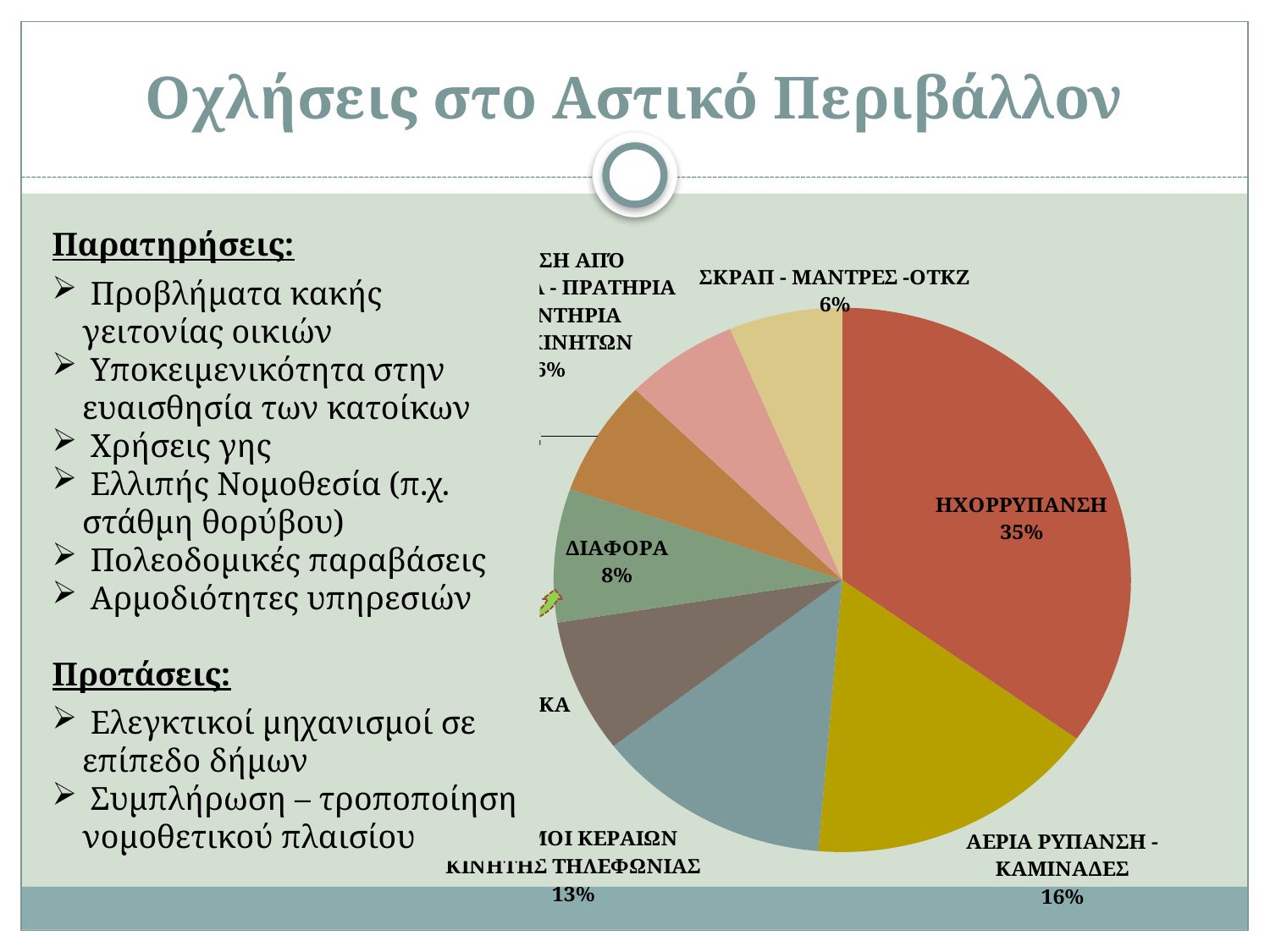
Which category has the largest slice of the pie? ΗΧΟΡΡΥΠΑΝΣΗ By how many percentage points does ΗΧΟΡΡΥΠΑΝΣΗ exceed ΑΕΡΙΑ ΡΥΠΑΝΣΗ - ΚΑΜΙΝΑΔΕΣ? 19 percentage points What colour is the ΗΧΟΡΡΥΠΑΝΣΗ slice? Red By how many percentage points does ΑΕΡΙΑ ΡΥΠΑΝΣΗ - ΚΑΜΙΝΑΔΕΣ exceed ΔΙΑΦΟΡΑ? 8 percentage points How many slices does the pie chart have? 8 What percentage is shown for ΣΚΡΑΠ - ΜΑΝΤΡΕΣ -ΟΤΚΖ? 6% Which is larger, the ΔΙΑΦΟΡΑ slice or the ΣΚΡΑΠ - ΜΑΝΤΡΕΣ -ΟΤΚΖ slice? ΔΙΑΦΟΡΑ What kind of chart is shown on the slide? Pie chart What percentage is shown for the slice labelled ΚΙΝΗΤΗΣ ΤΗΛΕΦΩΝΙΑΣ? 13% What percentage is shown for ΑΕΡΙΑ ΡΥΠΑΝΣΗ - ΚΑΜΙΝΑΔΕΣ? 16% What percentage is shown for the ΔΙΑΦΟΡΑ slice? 8% What percentage does the ΗΧΟΡΡΥΠΑΝΣΗ slice represent? 35%